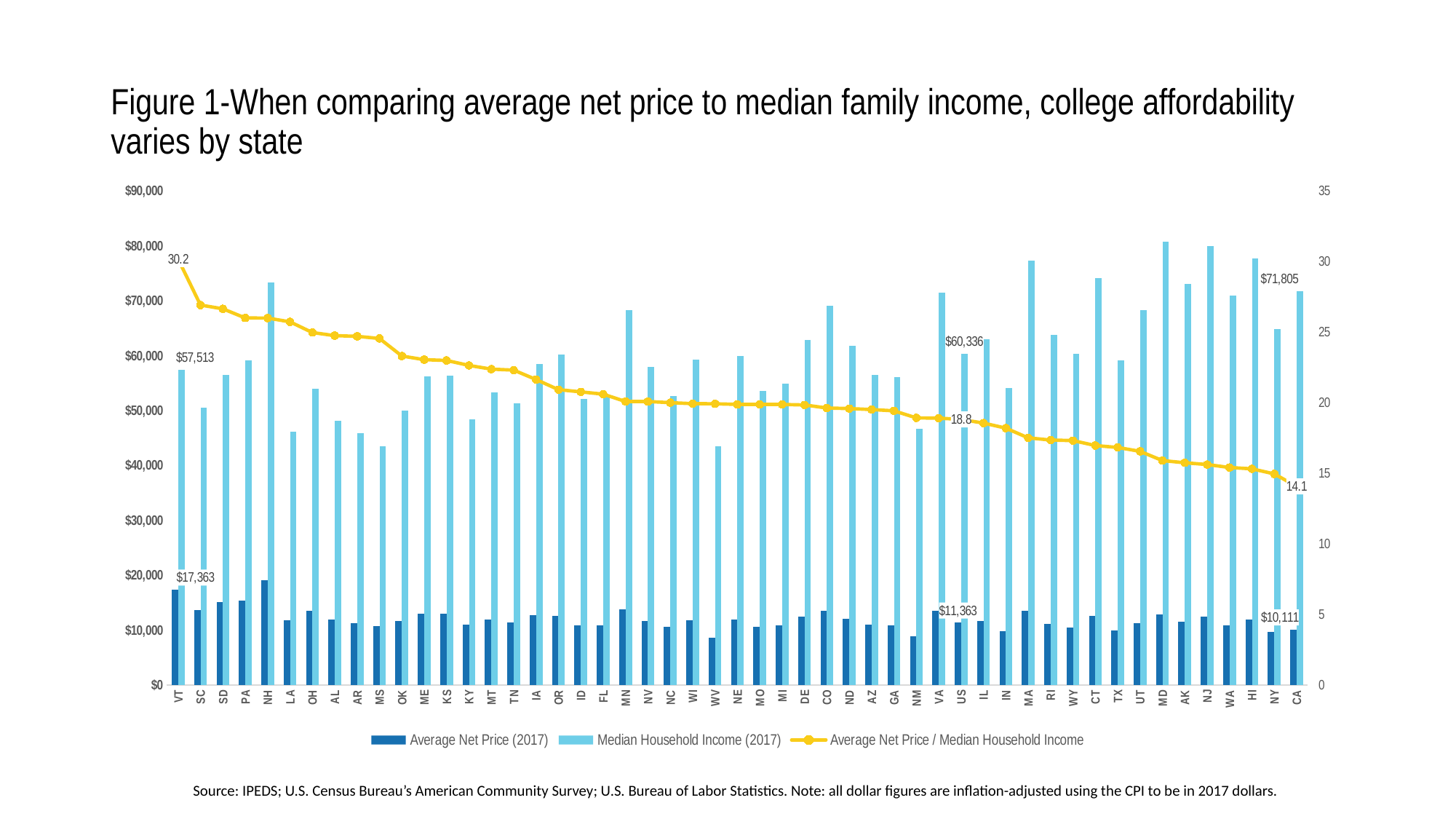
What is the Average Net Price (2017) for VT? $17,363 Does the Average Net Price / Median Household Income line rise or fall from left to right across the states? fall What is the Median Household Income (2017) for CA? $71,805 How many series does the legend list? 3 Which state has the highest Average Net Price / Median Household Income ratio? VT How much higher is the Median Household Income (2017) for CA than for VT? $14,292 Which has the higher Average Net Price (2017), NH or VT? NH Which state has the lowest Average Net Price / Median Household Income ratio? CA What is the Average Net Price / Median Household Income value for US? 18.8 Is the Median Household Income (2017) for NH greater or less than $70,000? greater What is the difference between the Average Net Price / Median Household Income ratio for VT and for CA? 16.1 Is the Median Household Income (2017) for WV greater or less than $50,000? less